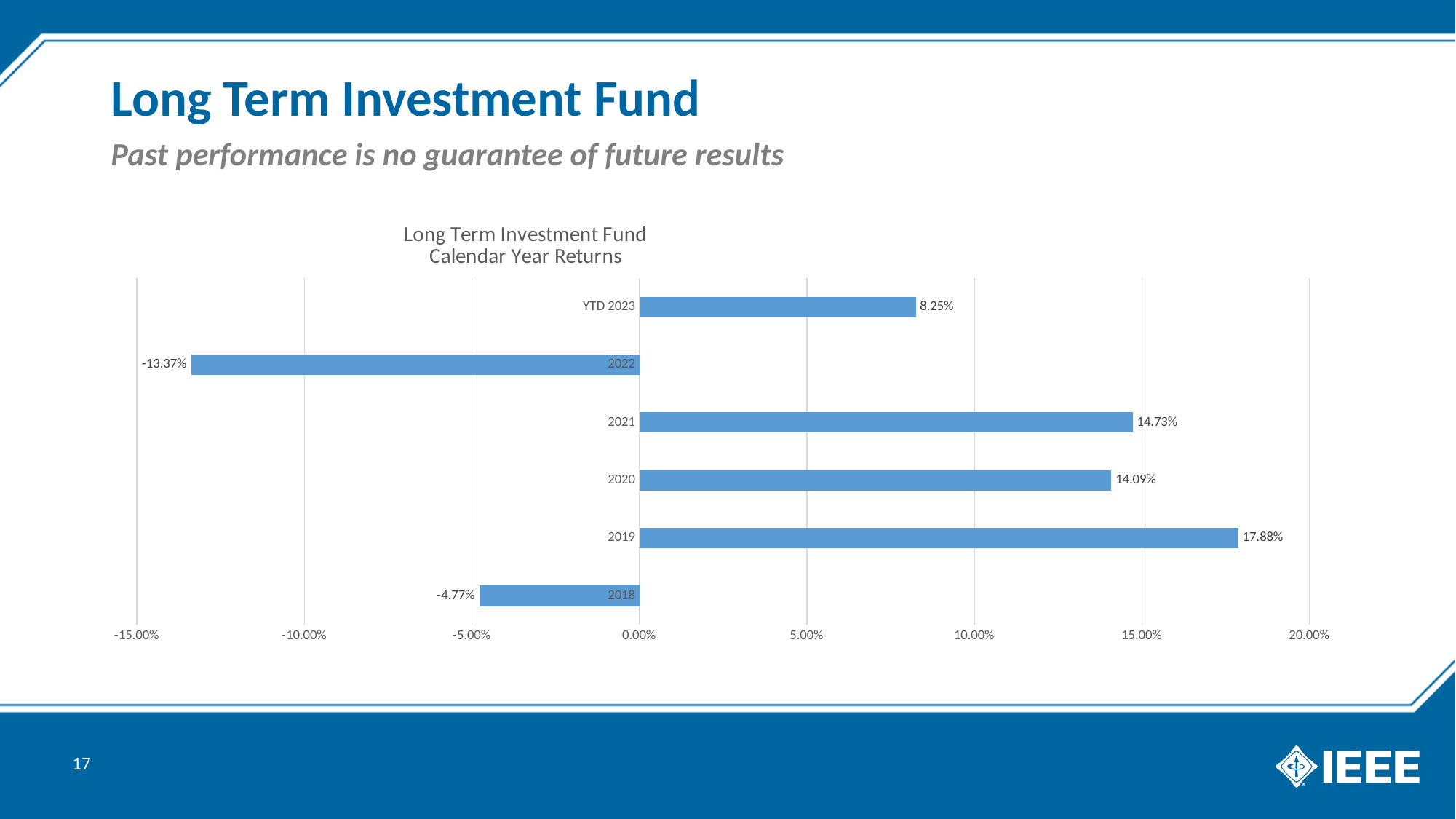
What is the return for 2022? -13.37% Which is larger, the return for 2021 or the return for 2020? 2021 Which year has the lowest return? 2022 What is the title of the chart? Long Term Investment Fund Calendar Year Returns What is the return for YTD 2023? 8.25% How many years are shown in the chart? 6 What is the difference between the 2021 and 2020 returns? 0.64% What is the return for 2019? 17.88% Is the value for 2019 greater or less than 15.00%? greater What kind of chart is shown on the slide? Bar chart Which year has the highest return? 2019 What is the return for 2018? -4.77%